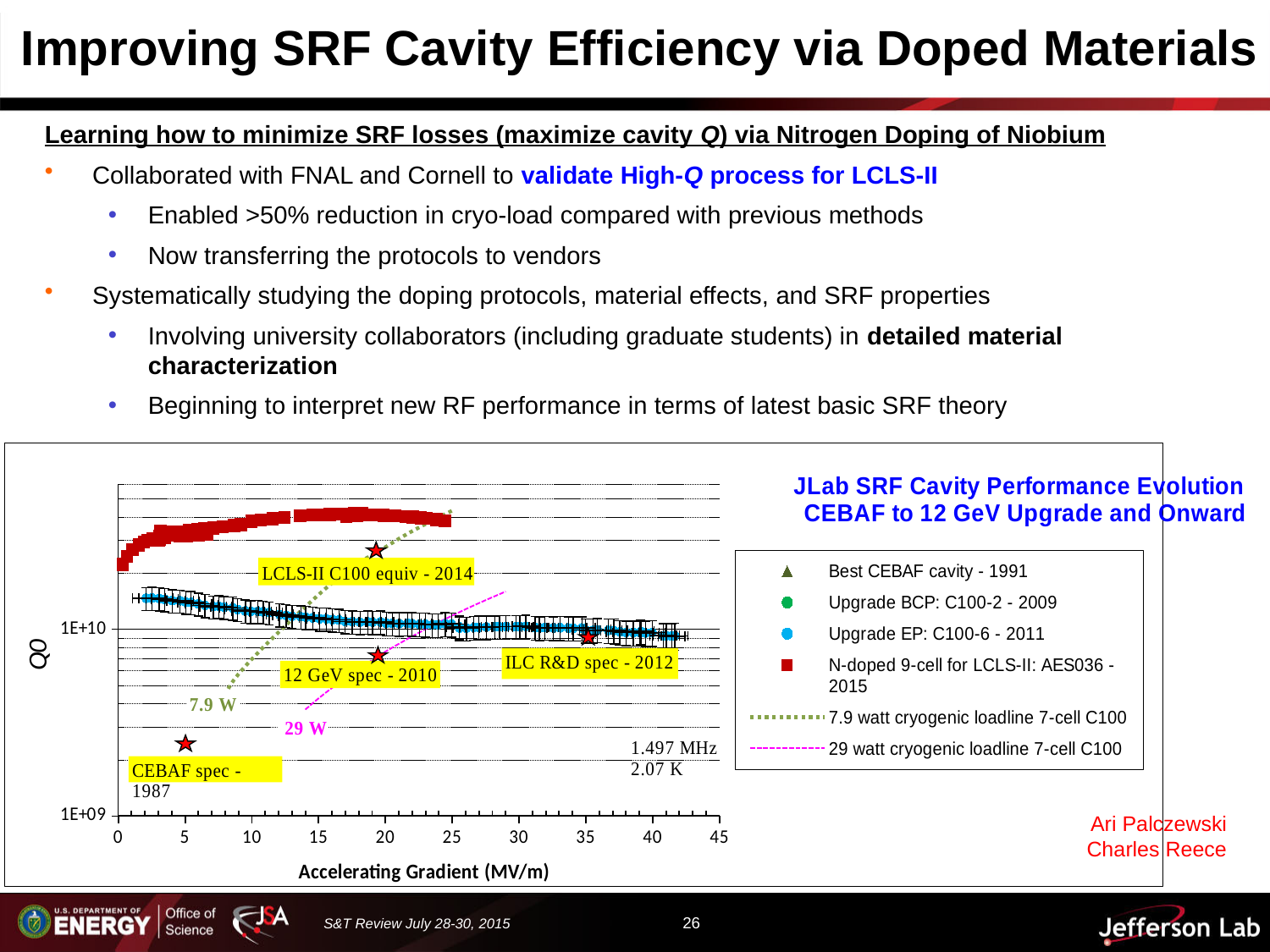
Which series has higher Q0 values at 20 MV/m: the N-doped 9-cell series or the Upgrade EP: C100-6 - 2011 series? N-doped 9-cell for LCLS-II: AES036 - 2015 What is the title of the chart? JLab SRF Cavity Performance Evolution CEBAF to 12 GeV Upgrade and Onward Is the Q0 value of the N-doped 9-cell series at 10 MV/m greater or less than 1E+10? greater How many series does the chart legend list? 6 What kind of chart is shown on the slide? scatter chart What is the highest tick value shown on the x axis of the chart? 45 What is the lowest tick value labelled on the Q0 axis? 1E+09 Which legend entry is represented by the red square markers? N-doped 9-cell for LCLS-II: AES036 - 2015 Which series has the highest Q0 values on the chart? N-doped 9-cell for LCLS-II: AES036 - 2015 Do the Q0 values of the Upgrade EP: C100-6 - 2011 series rise or fall as the accelerating gradient increases? fall How many cryogenic loadline series are listed in the chart legend? 2